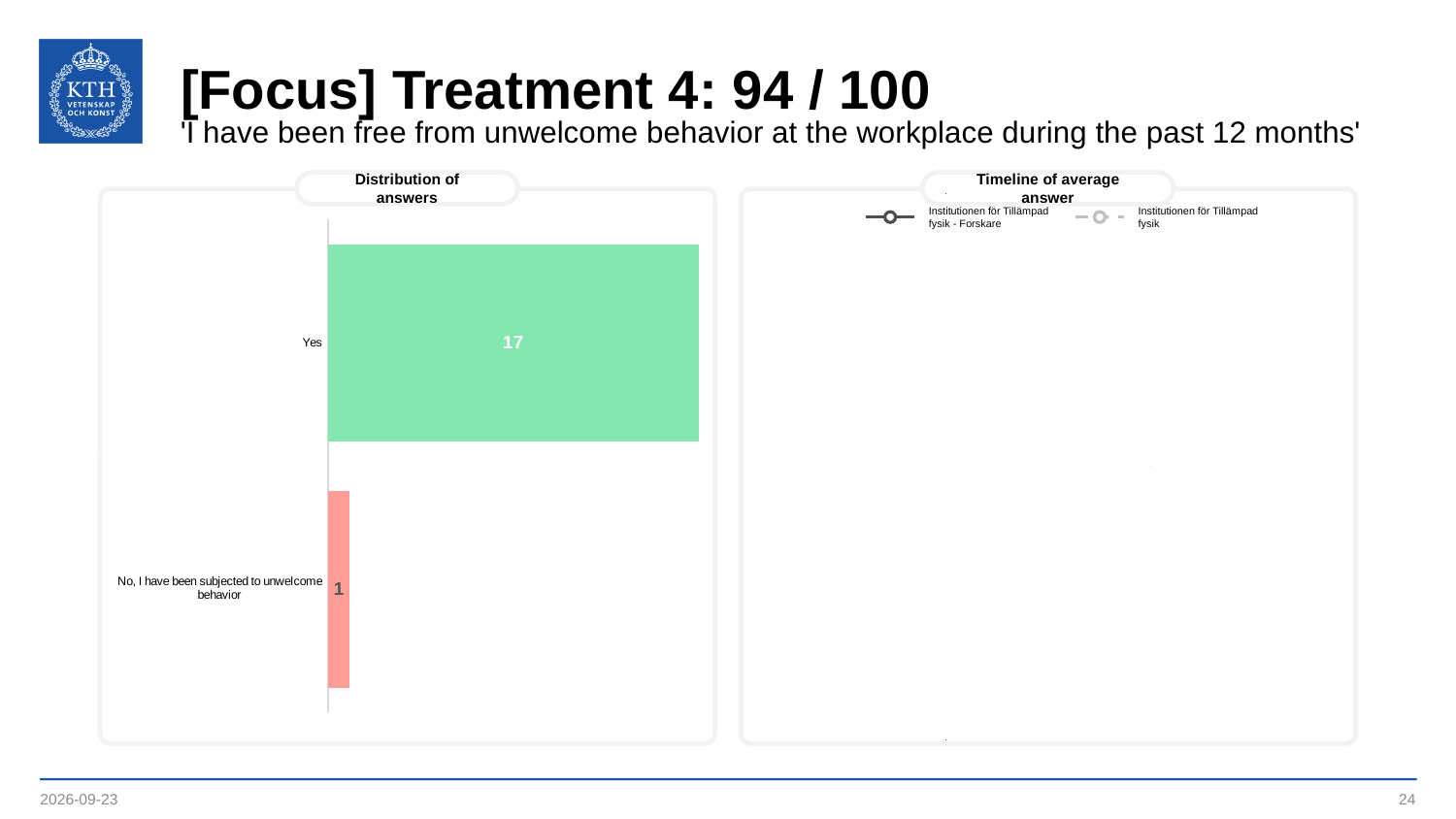
In the 'Distribution of answers' chart, which is larger: the value for 'Yes' or the value for 'No, I have been subjected to unwelcome behavior'? Yes In the 'Distribution of answers' chart, which category has the lowest value? No, I have been subjected to unwelcome behavior In the 'Distribution of answers' chart, what is the total of the two bars? 18 In the 'Distribution of answers' chart, what is the value for 'No, I have been subjected to unwelcome behavior'? 1 In the 'Distribution of answers' chart, what is the value for 'Yes'? 17 In the 'Distribution of answers' chart, which category has the highest value? Yes How many series does the legend of the 'Timeline of average answer' chart list? 2 How many categories are shown in the 'Distribution of answers' chart? 2 In the 'Distribution of answers' chart, what is the difference between the 'Yes' value and the 'No, I have been subjected to unwelcome behavior' value? 16 What is the title of the chart on the right side of the slide? Timeline of average answer In the 'Distribution of answers' chart, what colour is the 'Yes' bar? Green What kind of chart is the 'Distribution of answers' chart? Bar chart